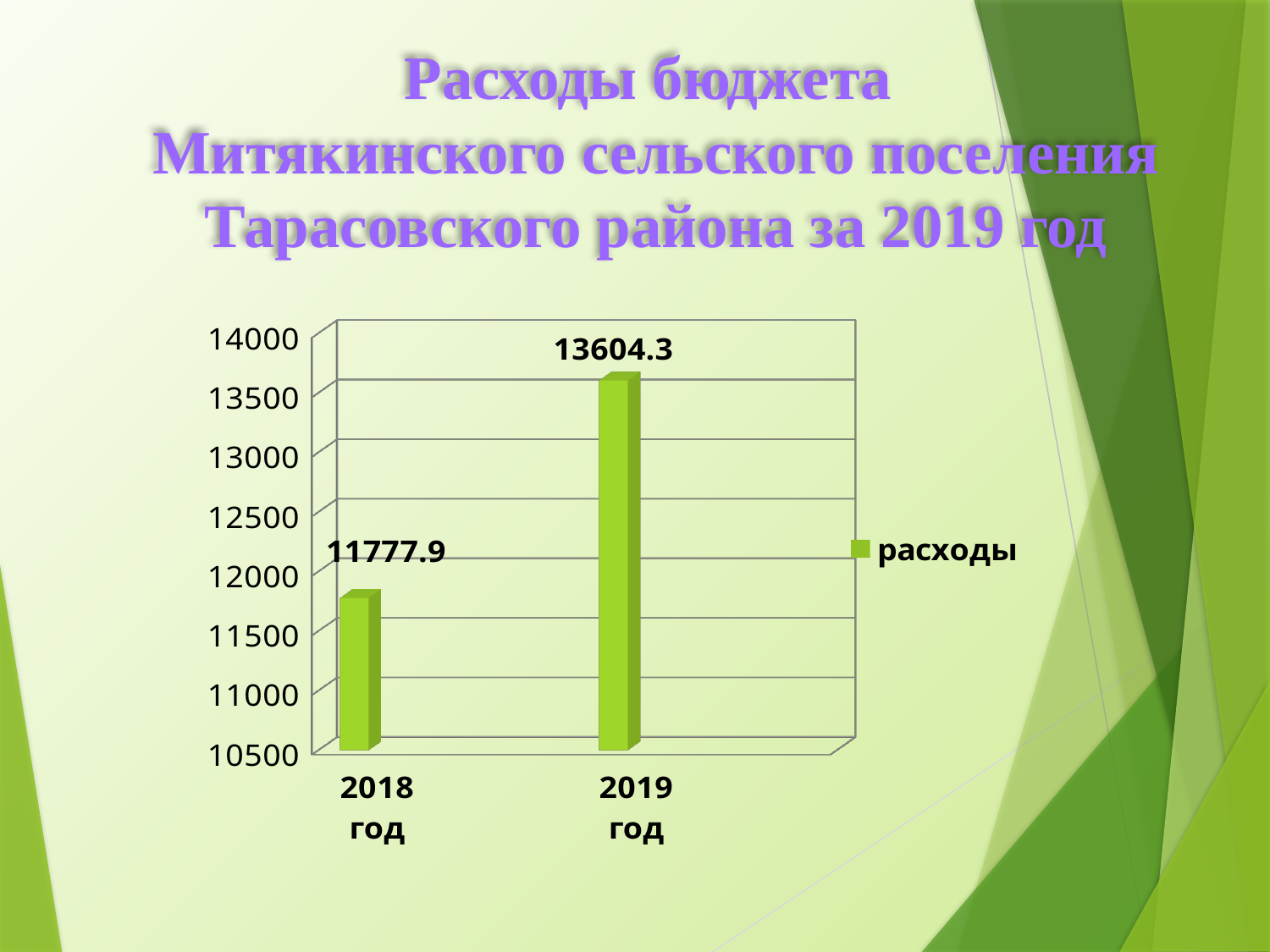
What is the name of the series in the legend? расходы Which year has the highest value? 2019 год How many categories are shown on the x axis? 2 What is the value for 2018 год? 11777.9 Is the value for 2019 год greater or less than 13500? greater Which year has the lowest value? 2018 год Is the value for 2018 год greater or less than 12000? less What is the difference between the values for 2019 год and 2018 год? 1826.4 What kind of chart is shown on the slide? bar chart Which is larger, the value for 2018 год or 2019 год? 2019 год What is the value for 2019 год? 13604.3 How many series does the legend list? 1